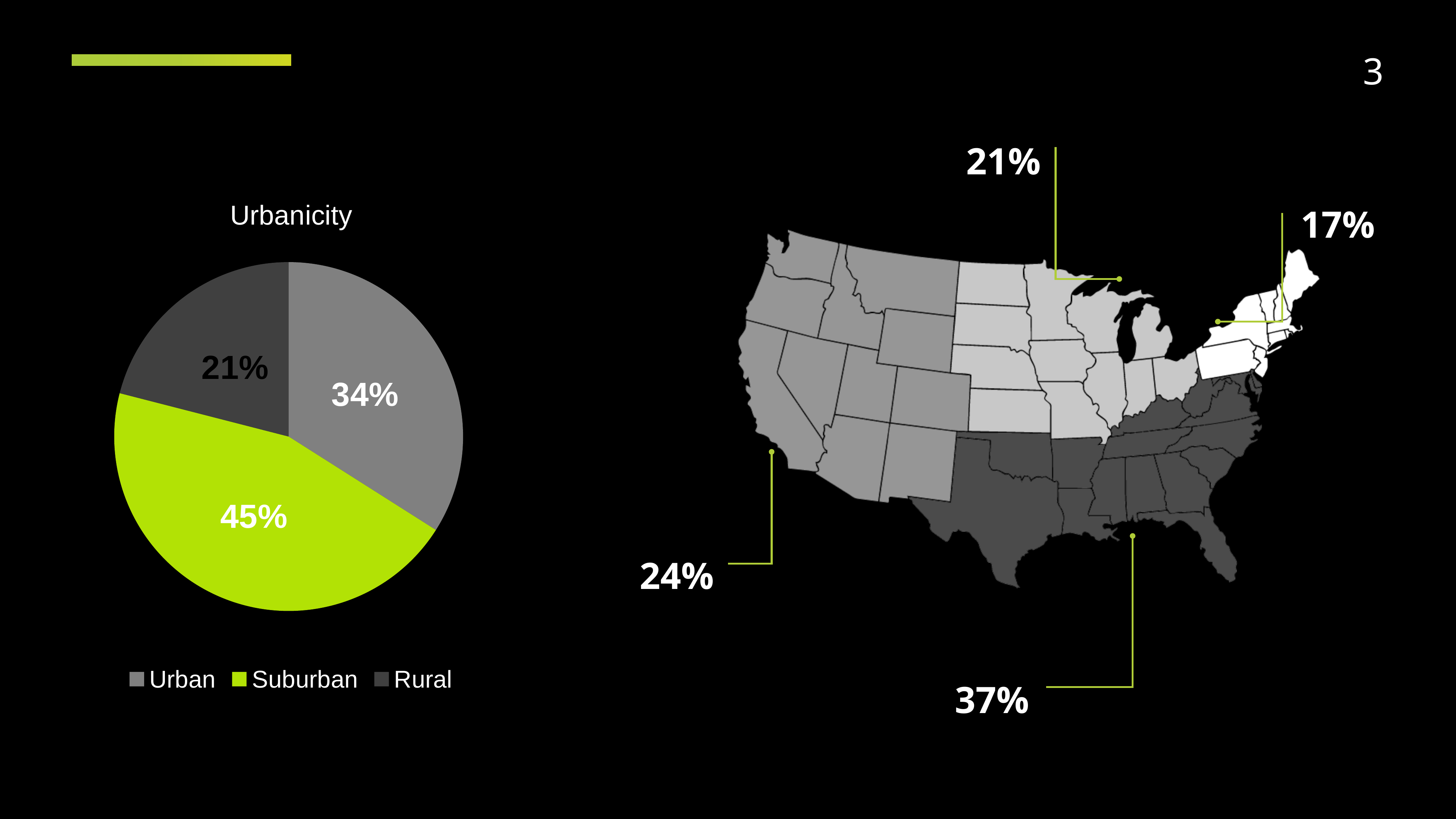
In the Urbanicity pie chart, what percentage is Suburban? 45% In the Urbanicity pie chart, what is the difference in percentage points between Suburban and Urban? 11 In the Urbanicity pie chart, what is the difference in percentage points between Urban and Rural? 13 What type of chart is the Urbanicity chart? Pie chart How many categories does the Urbanicity pie chart show? 3 In the Urbanicity pie chart, which category has the largest share? Suburban In the Urbanicity pie chart, what percentage is Rural? 21% In the Urbanicity pie chart, which is larger, Urban or Rural? Urban In the Urbanicity pie chart, which category has the smallest share? Rural In the Urbanicity pie chart, what percentage is Urban? 34% In the Urbanicity pie chart, what colour is the Suburban slice? Green What is the title of the pie chart on the left of the slide? Urbanicity